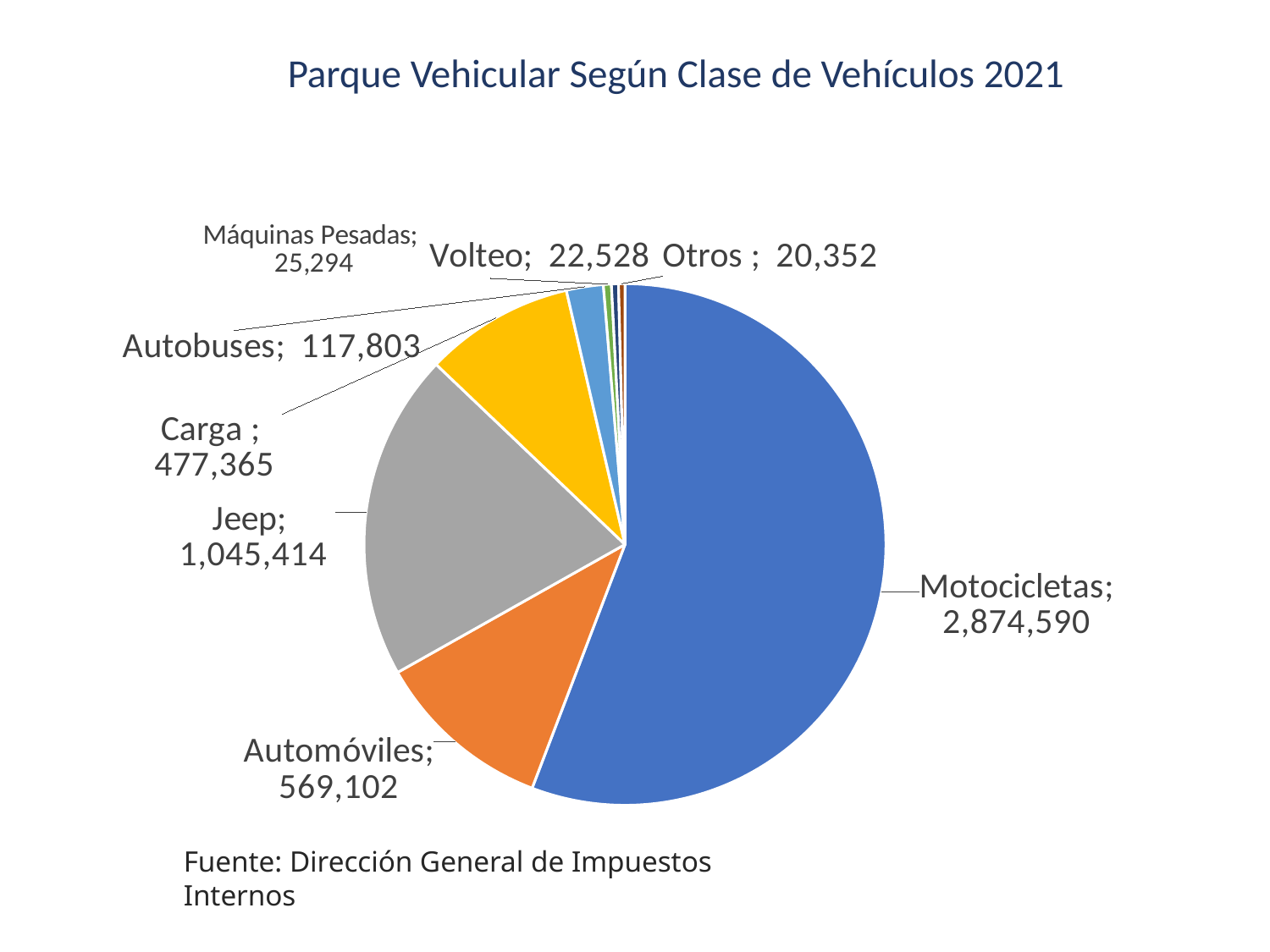
What is the difference between the values for Jeep and Automóviles? 476,312 Which is larger, the value for Carga or the value for Automóviles? Automóviles What is the title of the chart? Parque Vehicular Según Clase de Vehículos 2021 What kind of chart is shown on the slide? Pie chart What is the value for Máquinas Pesadas? 25,294 Which vehicle class has the largest slice of the pie? Motocicletas What is the value for Motocicletas? 2,874,590 How many vehicle classes are shown in the pie chart? 8 What is the difference between the values for Automóviles and Carga? 91,737 What is the value for Autobuses? 117,803 Which vehicle class has the smallest value? Otros What is the value for Jeep? 1,045,414